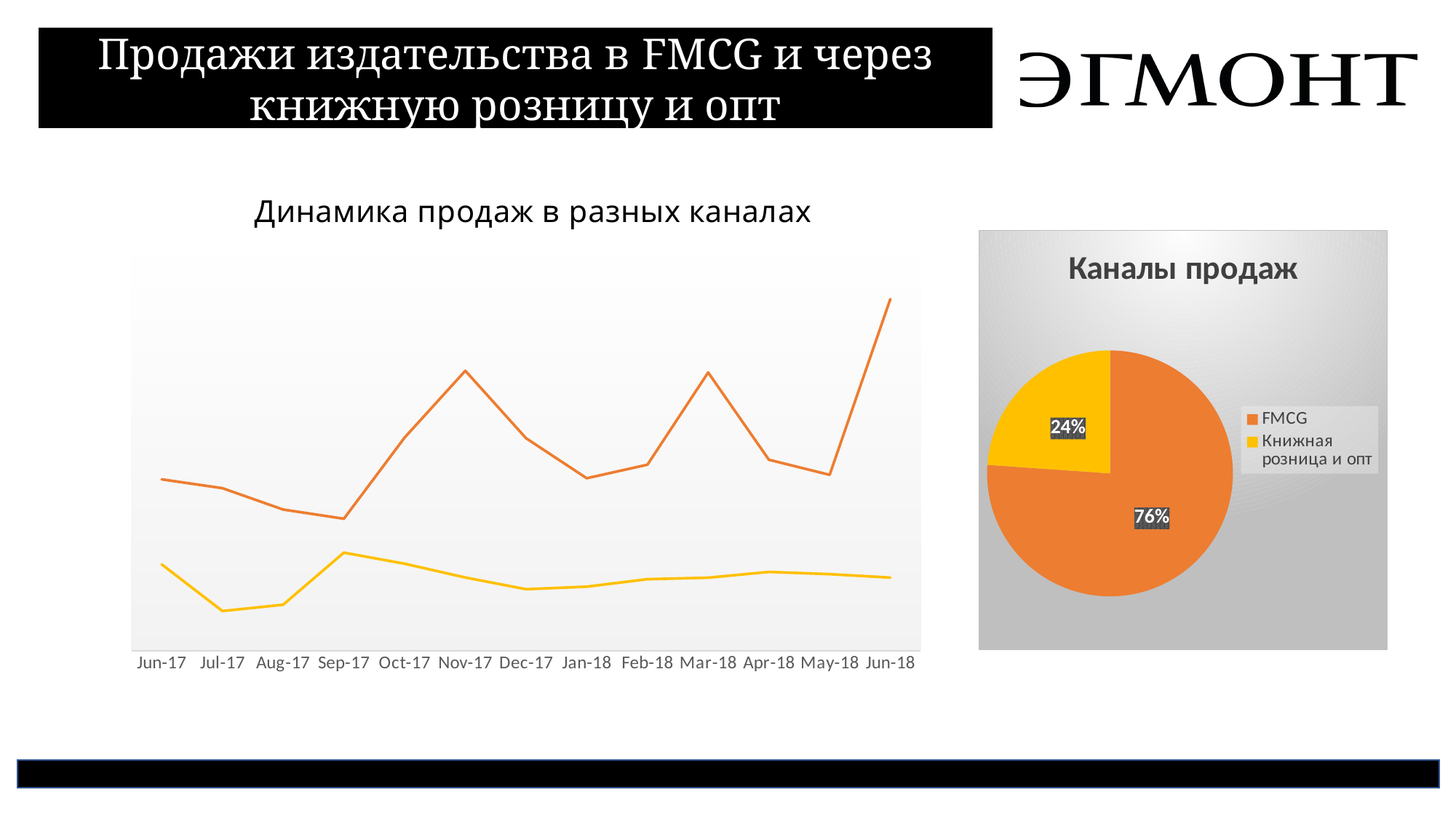
How many months are shown on the x axis of the chart 'Динамика продаж в разных каналах'? 13 In the pie chart 'Каналы продаж', by how many percentage points does FMCG exceed 'Книжная розница и опт'? 52 percentage points What kind of chart is 'Динамика продаж в разных каналах'? Line chart How many entries does the legend of the pie chart 'Каналы продаж' list? 2 What kind of chart is 'Каналы продаж'? Pie chart In the pie chart 'Каналы продаж', what share does FMCG have? 76% In the pie chart 'Каналы продаж', which channel has the largest share? FMCG In the pie chart 'Каналы продаж', which channel has the smallest share? Книжная розница и опт In the chart 'Динамика продаж в разных каналах', does the orange line rise or fall from May-18 to Jun-18? Rise In the chart 'Динамика продаж в разных каналах', in which month does the orange line reach its highest point? Jun-18 In the pie chart 'Каналы продаж', what share does 'Книжная розница и опт' have? 24% In the chart 'Динамика продаж в разных каналах', in which month does the yellow line reach its lowest point? Jul-17